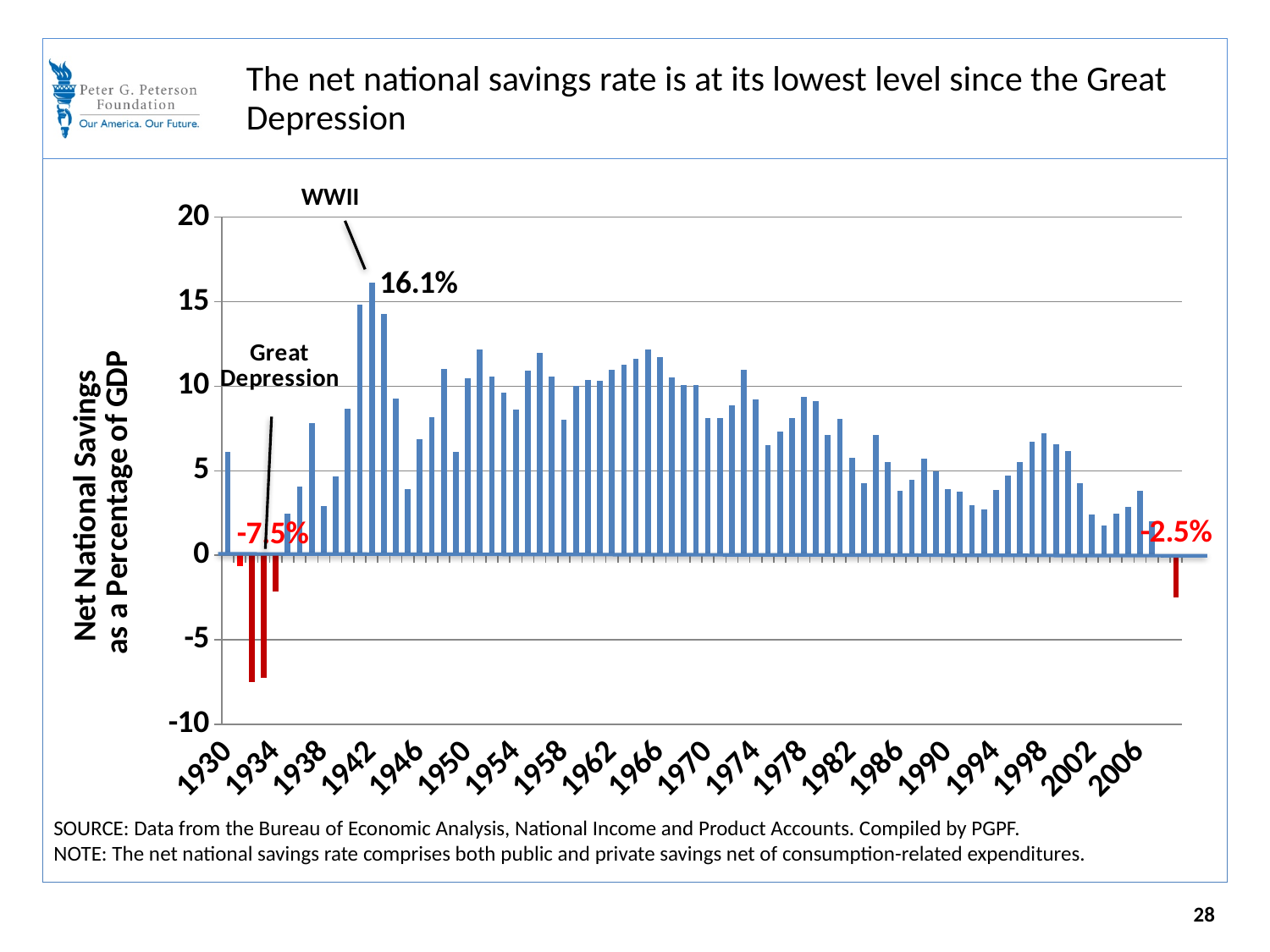
What is the difference between the WWII peak of 16.1% and the Great Depression low of -7.5%? 23.6 percentage points What is the lowest net national savings rate labeled on the chart, reached during the Great Depression? -7.5% Do the values generally rise or fall from 1966 to 1994? fall Is the value for 1966 greater or less than 10? greater What is the difference between the Great Depression low of -7.5% and the recent low of -2.5%? 5 percentage points What kind of chart is shown on the slide? bar chart What is the highest net national savings rate labeled on the chart, reached during WWII? 16.1% Which is lower, the Great Depression low or the recent low labeled -2.5%? the Great Depression low (-7.5%) What is the title of the vertical axis? Net National Savings as a Percentage of GDP What value is labeled on the final red bar at the right end of the chart? -2.5% Is the value for 1942 greater or less than 10? greater Is the value for 1994 greater or less than 5? less